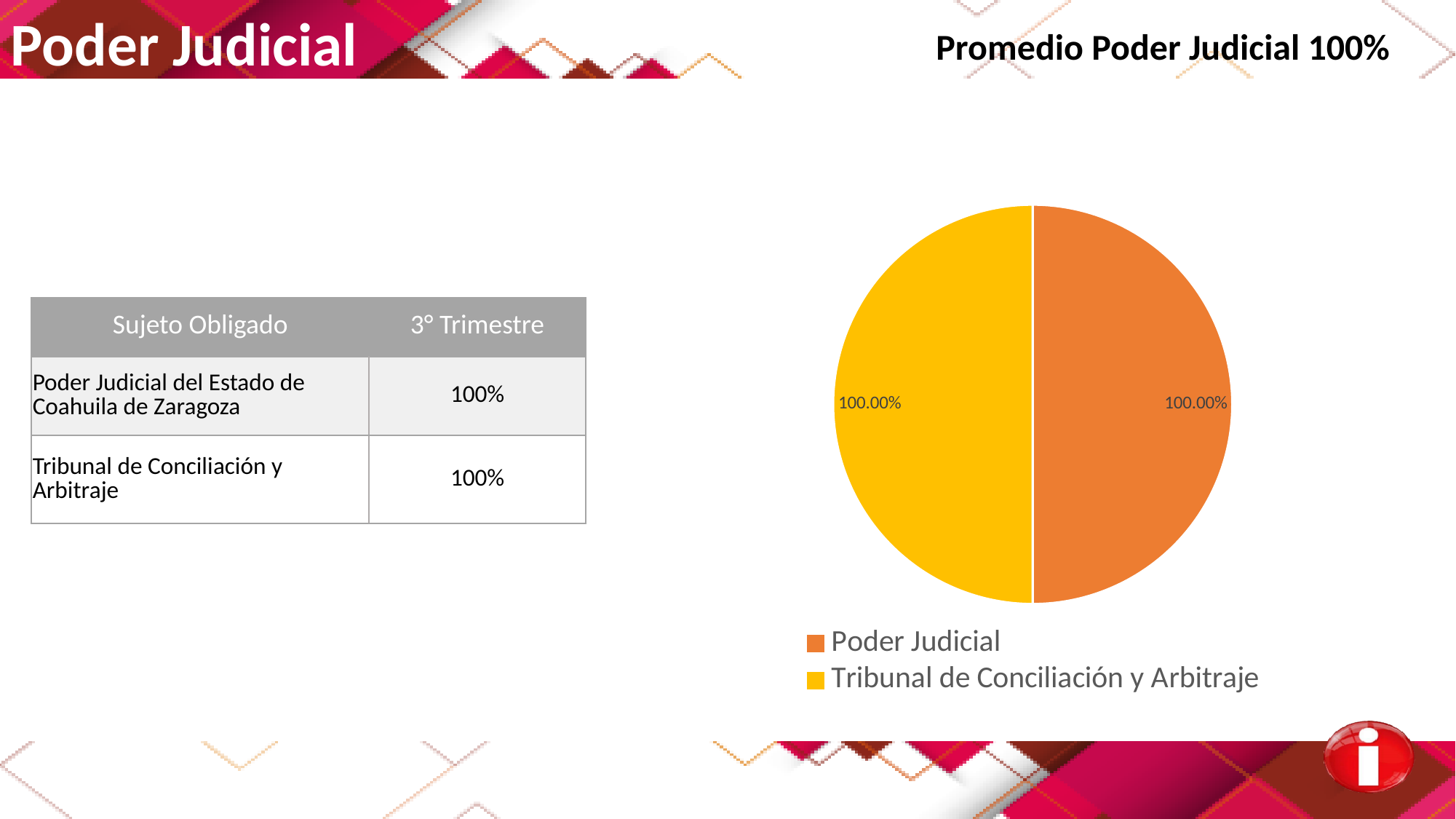
What is the difference between the labelled values for Poder Judicial and Tribunal de Conciliación y Arbitraje? 0.00% How many entries does the legend of the pie chart list? 2 Which colour represents Poder Judicial in the pie chart? orange What kind of chart is shown on the slide? pie chart What value is labelled on the Poder Judicial slice of the pie chart? 100.00% What value is labelled on the Tribunal de Conciliación y Arbitraje slice of the pie chart? 100.00% Which legend entry is shown in yellow in the pie chart? Tribunal de Conciliación y Arbitraje Is the labelled value for Poder Judicial larger than, smaller than, or equal to the labelled value for Tribunal de Conciliación y Arbitraje? equal How many slices does the pie chart have? 2